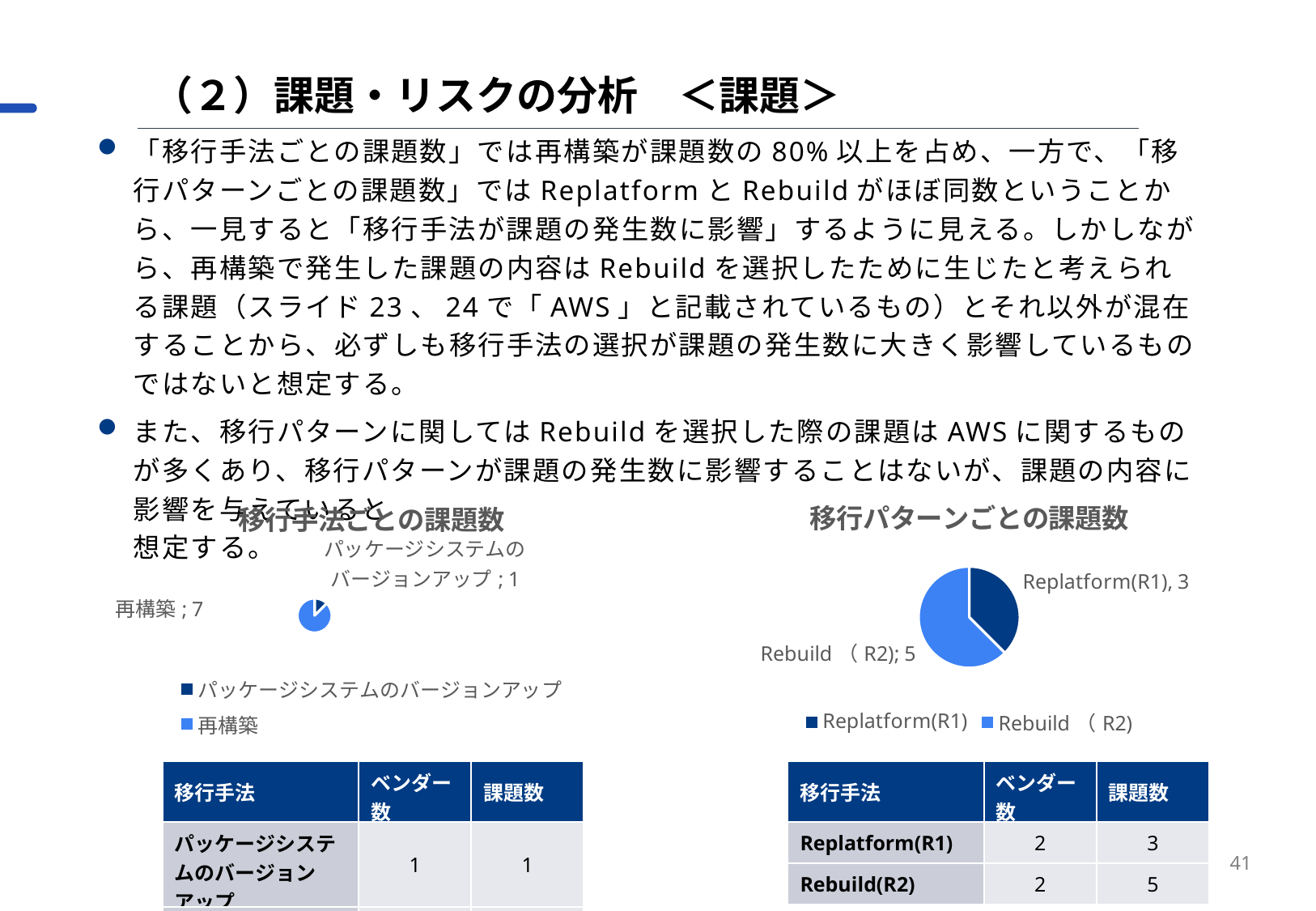
In the chart titled 移行手法ごとの課題数, what is the value for 再構築? 7 In the chart titled 移行パターンごとの課題数, which is larger, the value for Rebuild (R2) or Replatform(R1)? Rebuild (R2) In the chart titled 移行パターンごとの課題数, what is the value for Rebuild (R2)? 5 In the chart titled 移行パターンごとの課題数, what is the value for Replatform(R1)? 3 In the chart titled 移行手法ごとの課題数, how many entries does the legend list? 2 In the chart titled 移行手法ごとの課題数, what is the difference between the values for 再構築 and パッケージシステムのバージョンアップ? 6 In the chart titled 移行パターンごとの課題数, which category has the lowest value? Replatform(R1) In the chart titled 移行手法ごとの課題数, which category has the highest value? 再構築 In the chart titled 移行手法ごとの課題数, what is the value for パッケージシステムのバージョンアップ? 1 In the chart titled 移行パターンごとの課題数, what is the difference between the values for Rebuild (R2) and Replatform(R1)? 2 In the chart titled 移行手法ごとの課題数, what kind of chart is shown? pie chart In the chart titled 移行パターンごとの課題数, how many slices does the pie have? 2